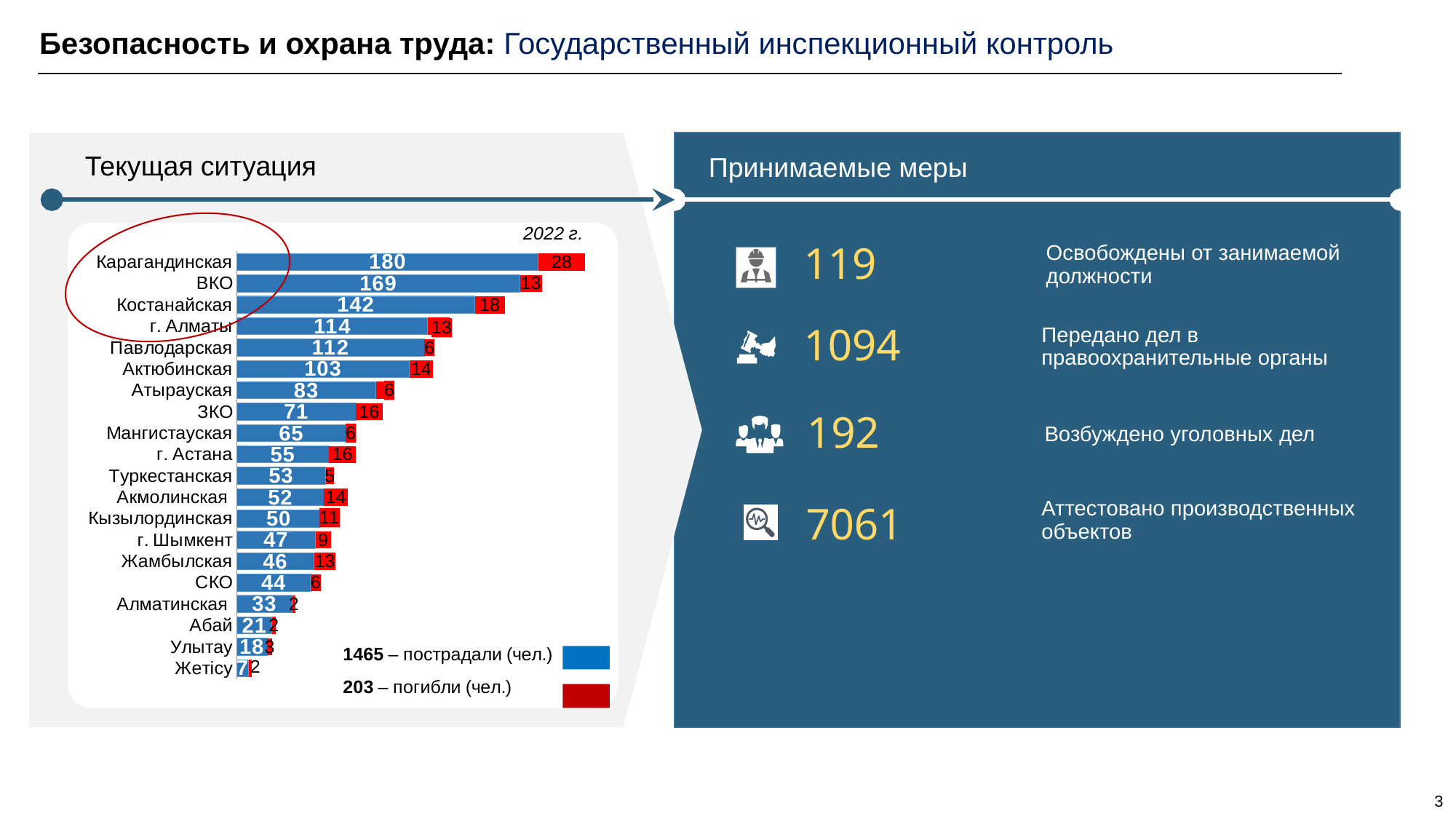
How many deaths (погибли) are shown for Костанайская? 18 How many series does the chart legend list? 2 What kind of chart is shown on the slide? bar chart How many regions are listed in the chart? 20 Which region has the lowest number of injured (пострадали)? Жетісу What is the difference in injured (пострадали) between ВКО and Костанайская? 27 Which region has the highest number of injured (пострадали)? Карагандинская How many injured (пострадали) are shown for Актюбинская? 103 Which has more deaths (погибли): ЗКО or Павлодарская? ЗКО Which year does the chart refer to? 2022 г. What is the total of the stacked bar for г. Алматы (injured plus deaths)? 127 How many injured (пострадали) are shown for Карагандинская? 180